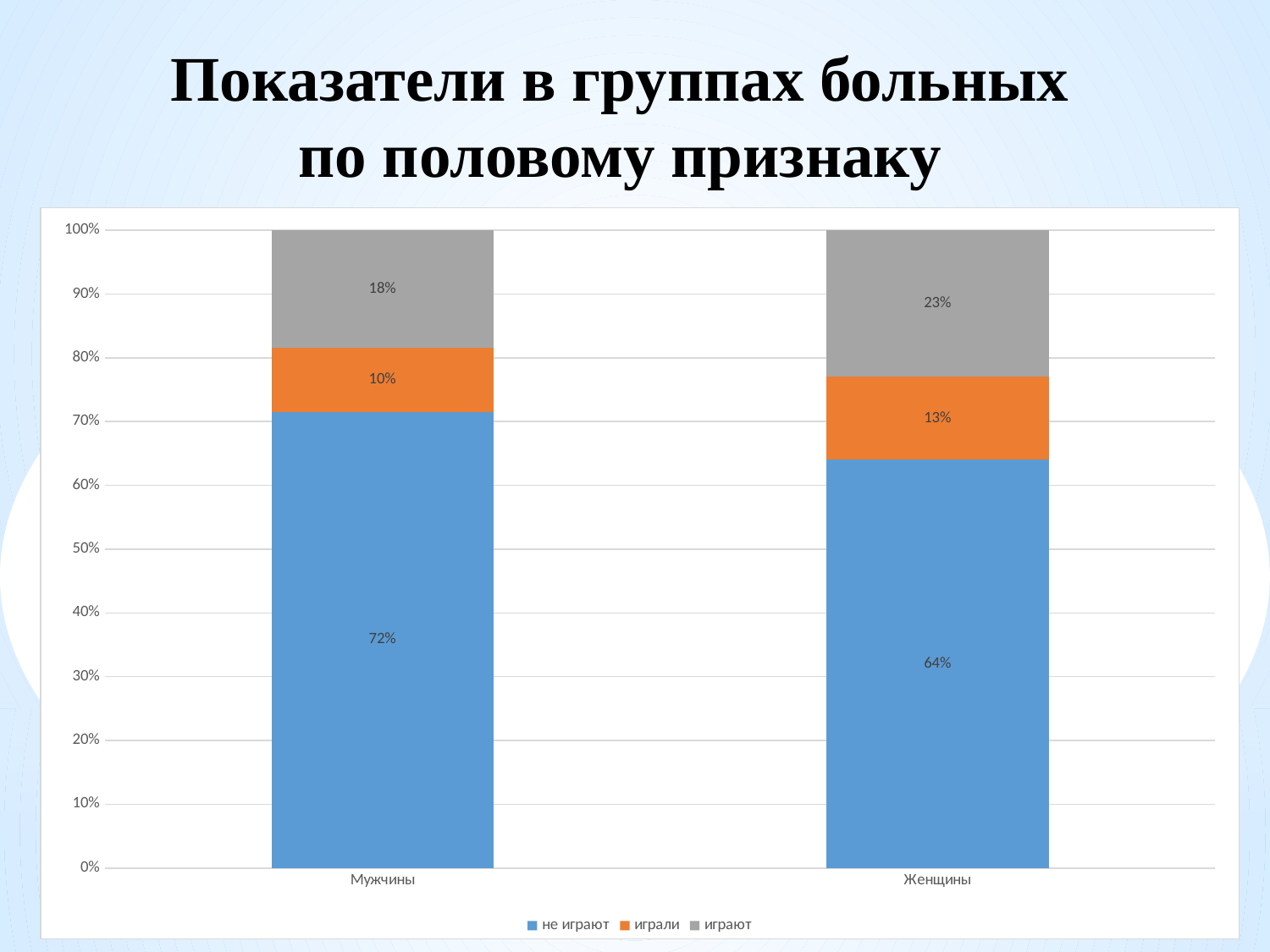
Which category has the higher value for "не играют", "Мужчины" or "Женщины"? Мужчины How many series does the legend list? 3 What is the value for "не играют" in the "Мужчины" category? 72% What kind of chart is shown on the slide? Stacked bar chart What is the difference between the "не играют" values for "Мужчины" and "Женщины"? 8% Which series is shown in orange in the legend? играли What is the value for "играют" in the "Женщины" category? 23% What is the difference between the "играют" values for "Женщины" and "Мужчины"? 5% What is the value for "играли" in the "Женщины" category? 13% What is the value for "не играют" in the "Женщины" category? 64% How many categories are shown on the x axis? 2 What is the value for "играли" in the "Мужчины" category? 10%